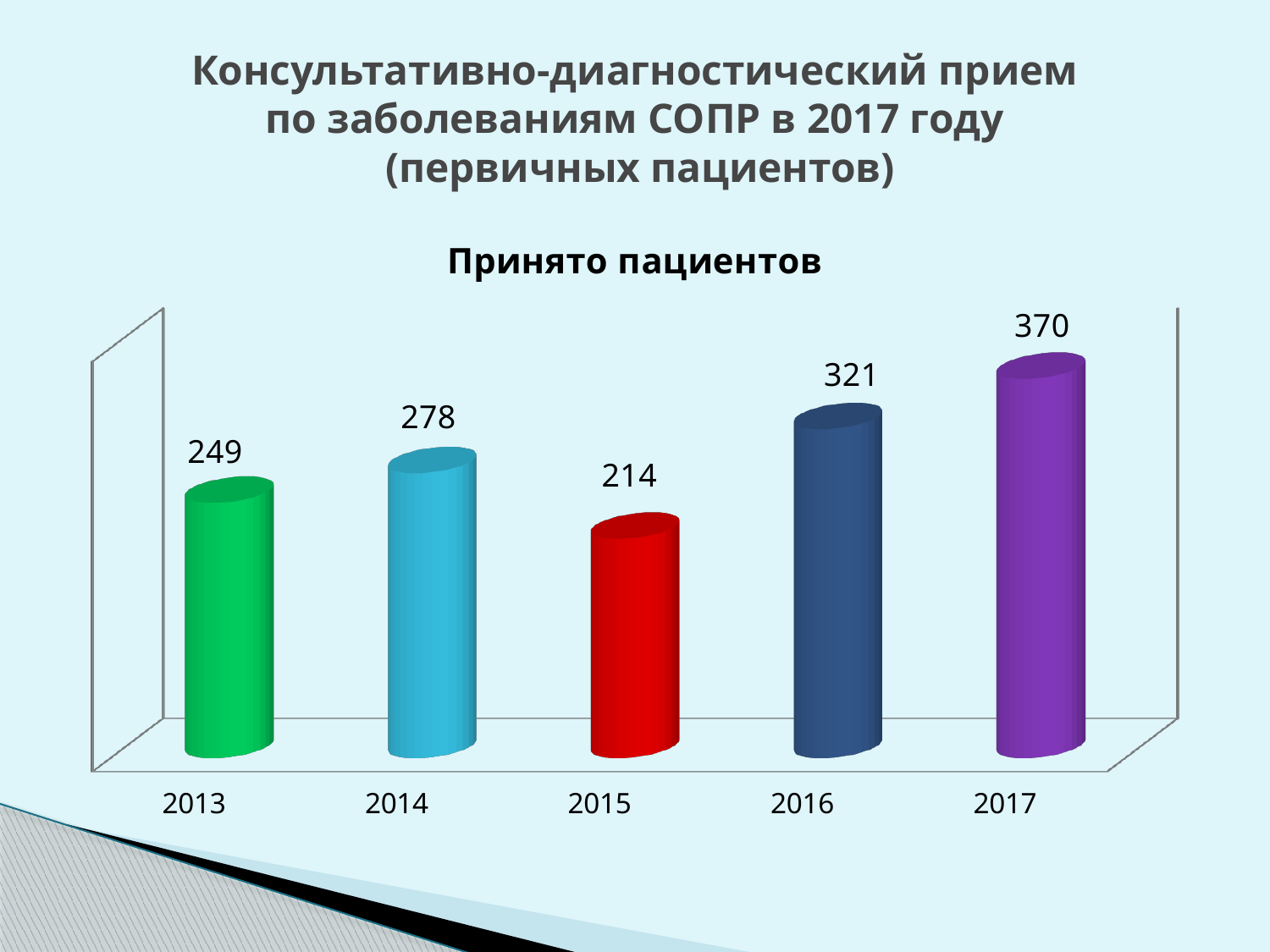
What is the difference between the values for 2014 and 2015? 64 What is the difference between the values for 2017 and 2016? 49 What kind of chart is this? bar chart Which is larger, the value for 2014 or the value for 2013? 2014 Which year has the lowest value? 2015 Which year has the highest value? 2017 What is the title of the chart? Принято пациентов How many years are shown on the chart? 5 What is the value for 2013? 249 What is the value for 2017? 370 Do the values rise or fall from 2015 to 2017? rise What is the value for 2015? 214